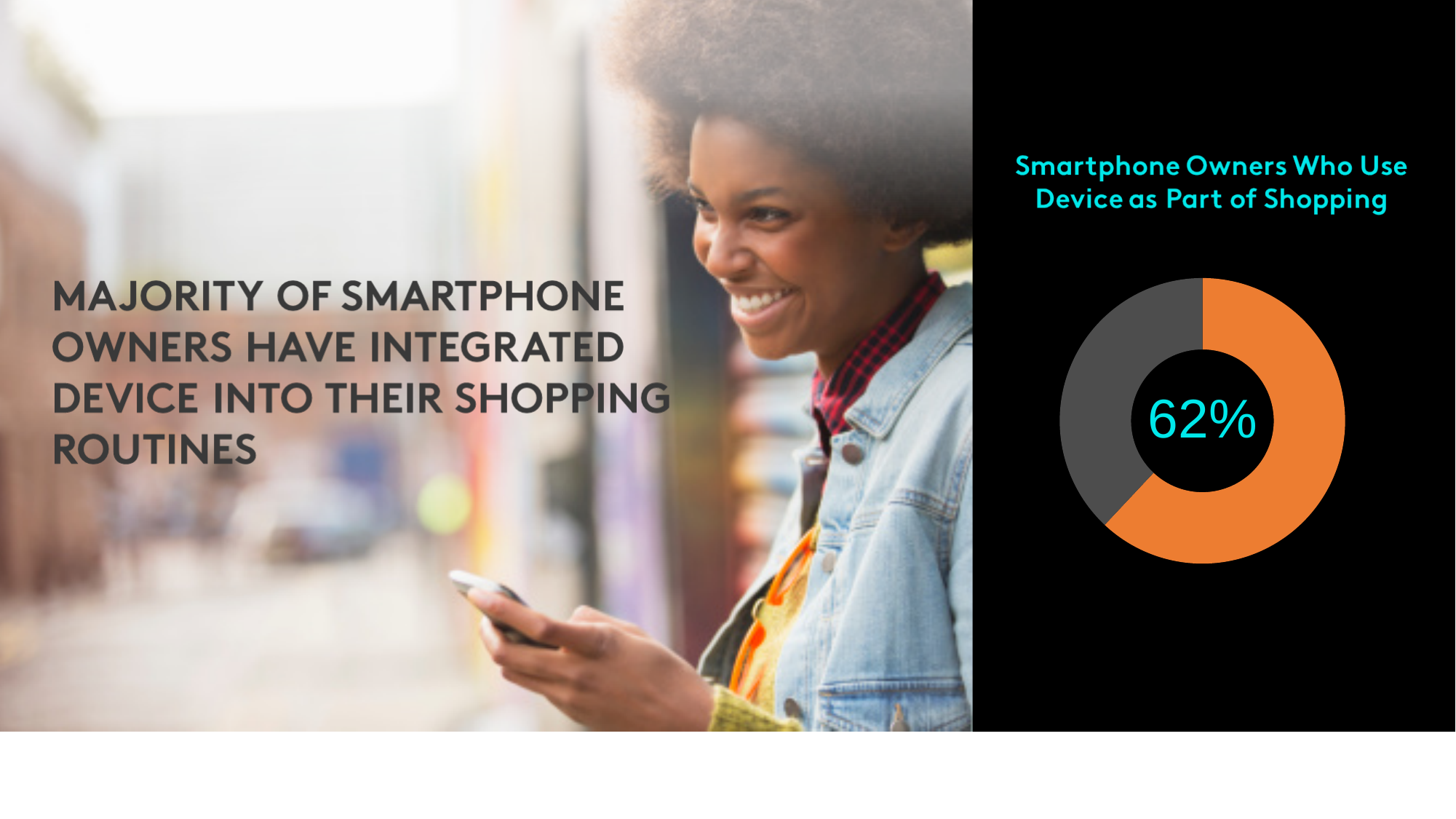
Which segment of the donut chart is larger, the orange one or the grey one? The orange one What colour is the segment representing the 62% value? Orange What percentage of smartphone owners use their device as part of shopping, according to the chart? 62% What share of the donut chart does the orange segment represent? 62% What kind of chart is shown on the slide? Donut (pie) chart How many segments does the donut chart have? 2 What is the title of the chart? Smartphone Owners Who Use Device as Part of Shopping